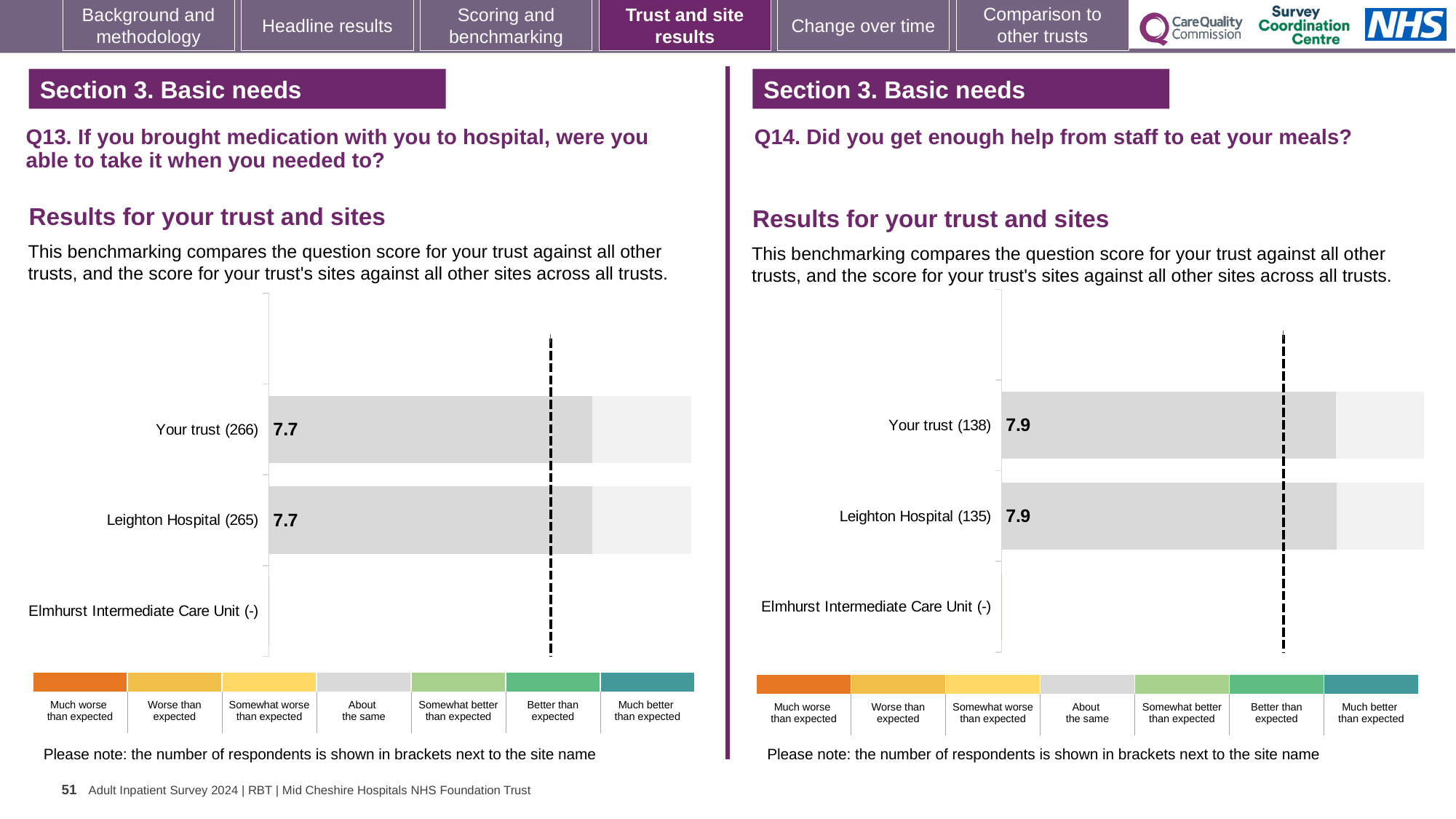
In the Q13 chart on the left, what is the score for Your trust? 7.7 In the Q14 chart on the right, what is the score for Your trust? 7.9 In the Q13 chart on the left, what is the score for Leighton Hospital? 7.7 What kind of chart is used for the Q14 results on the right? Bar chart In the Q13 chart on the left, how many respondents are shown in brackets for Your trust? 266 In the Q14 chart on the right, which site has no score shown (marked with a dash)? Elmhurst Intermediate Care Unit In the Q13 chart on the left, what is the difference between the score for Your trust and the score for Leighton Hospital? 0 In the Q13 chart on the left, how many sites or categories are listed on the vertical axis? 3 In the Q14 chart on the right, what is the score for Leighton Hospital? 7.9 In the Q14 chart on the right, how many respondents are shown in brackets for Leighton Hospital? 135 In the Q13 chart on the left, how many benchmark categories are shown in the colour key below the chart? 7